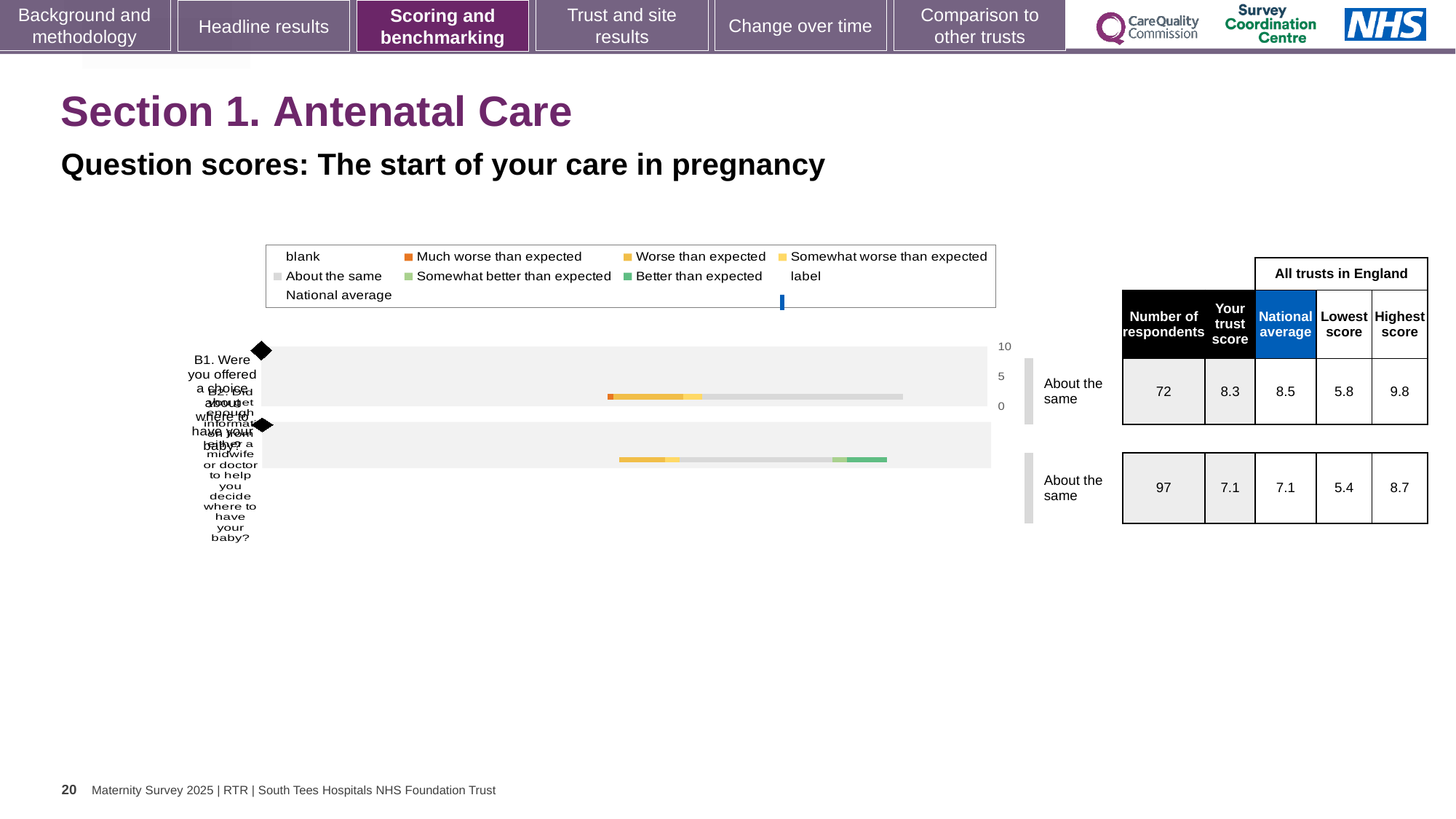
Which question has the higher trust score in the table next to the chart, B1 or B2? B1 What kind of chart is used to show the question scores on this slide? bar chart In the table next to the chart, how many respondents answered B1? 72 How many questions (categories) are plotted in the chart? 2 In the table next to the chart, what is the highest score among all trusts in England for B2? 8.7 In the table next to the chart, what is the trust score for B1 (Were you offered a choice about where to have your baby?)? 8.3 According to the table next to the chart, is the trust score for B1 higher or lower than the national average for B1? lower According to the table next to the chart, which question had more respondents, B1 or B2? B2 In the table next to the chart, what is the national average for B2 (Did you get enough information from either a midwife or doctor to help you decide where to have your baby?)? 7.1 Using the table next to the chart, what is the difference between the highest score and the lowest score for B1? 4.0 Using the table next to the chart, what is the difference between the highest score and the lowest score for B2? 3.3 What benchmark category is shown beside the bar for B1? About the same